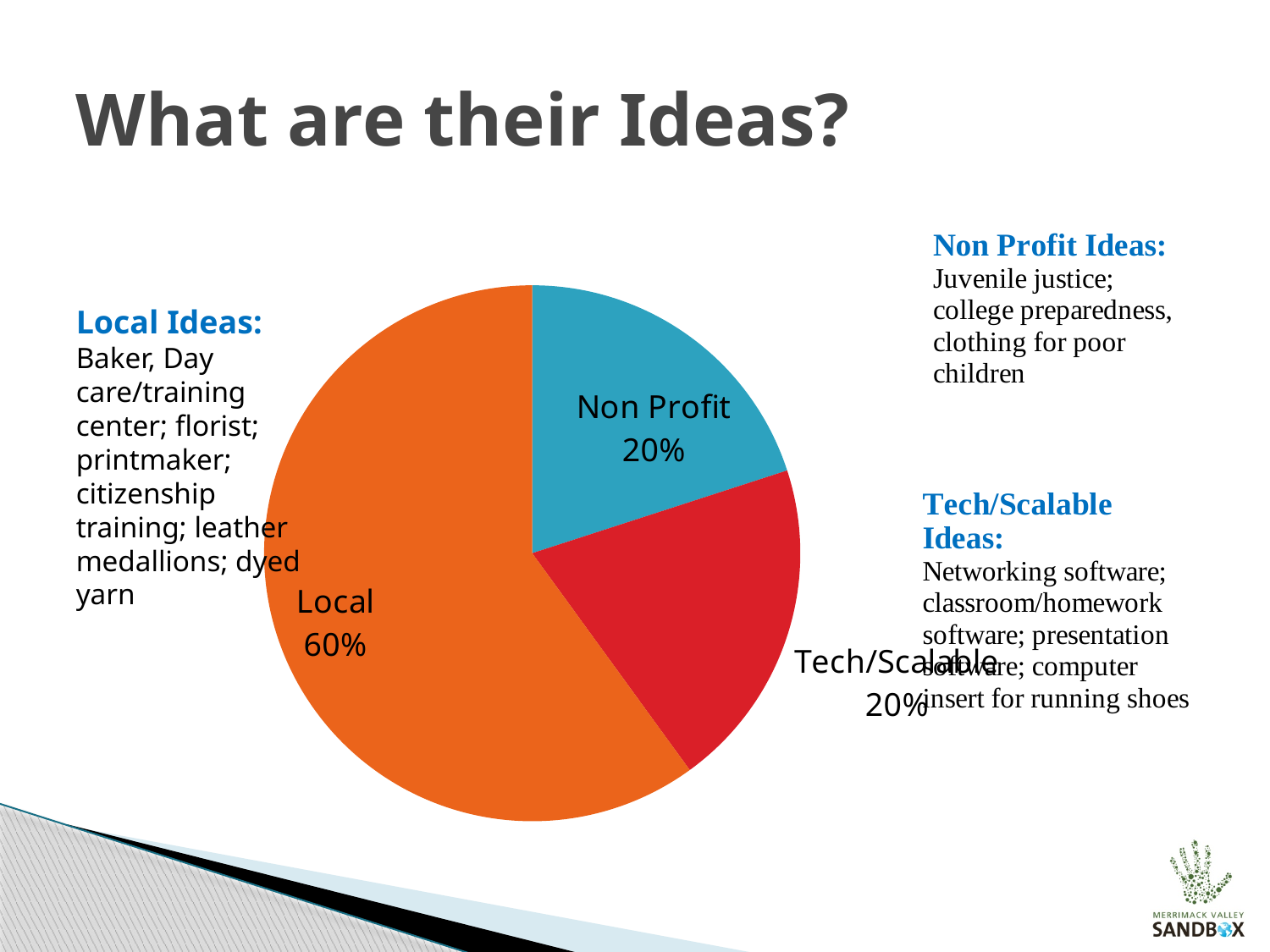
Which category has the largest slice of the pie? Local What colour is the Local slice of the pie? orange What colour is the Non Profit slice of the pie? blue What kind of chart is shown on the slide? pie chart What share of the pie does Local represent? 60% What share of the pie does Non Profit represent? 20% What share of the pie does Tech/Scalable represent? 20% Which is larger, the Local slice or the Tech/Scalable slice? Local Is the share for Local greater or less than 50%? greater How many slices does the pie chart have? 3 What is the difference between the Local share and the Non Profit share? 40%